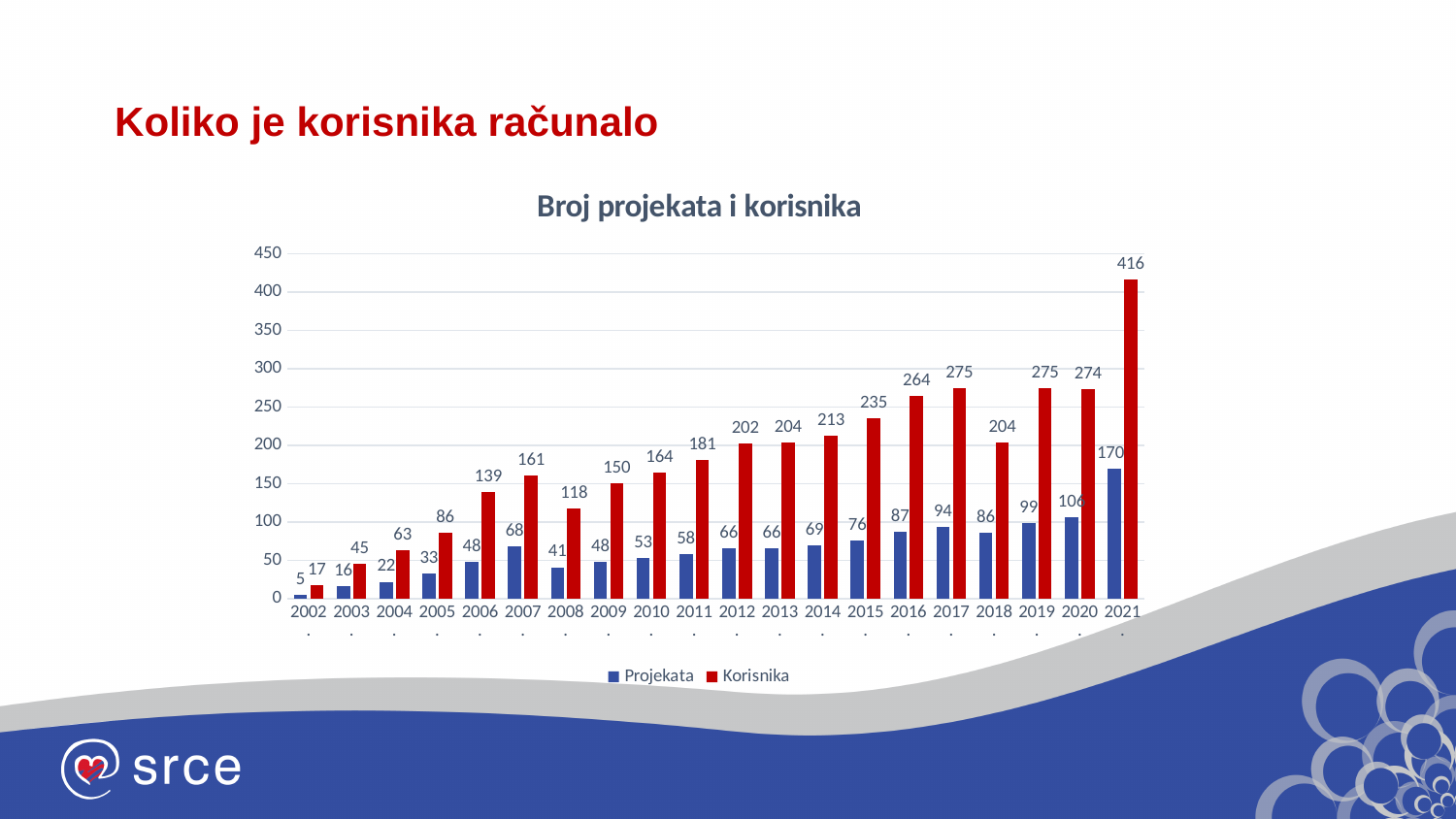
How many series does the legend list? 2 Which year has the highest Korisnika value? 2021 How many years are shown on the x axis? 20 What kind of chart is shown? bar chart Is the Projekata value for 2021 greater or less than 150? greater Which is larger, the Korisnika value for 2016 or for 2018? 2016 What is the difference between the Korisnika values for 2021 and 2020? 142 What is the value of Projekata for 2020? 106 What is the title of the chart? Broj projekata i korisnika Which year has the lowest Projekata value? 2002 What is the value of Korisnika for 2008? 118 What is the value of Korisnika for 2021? 416